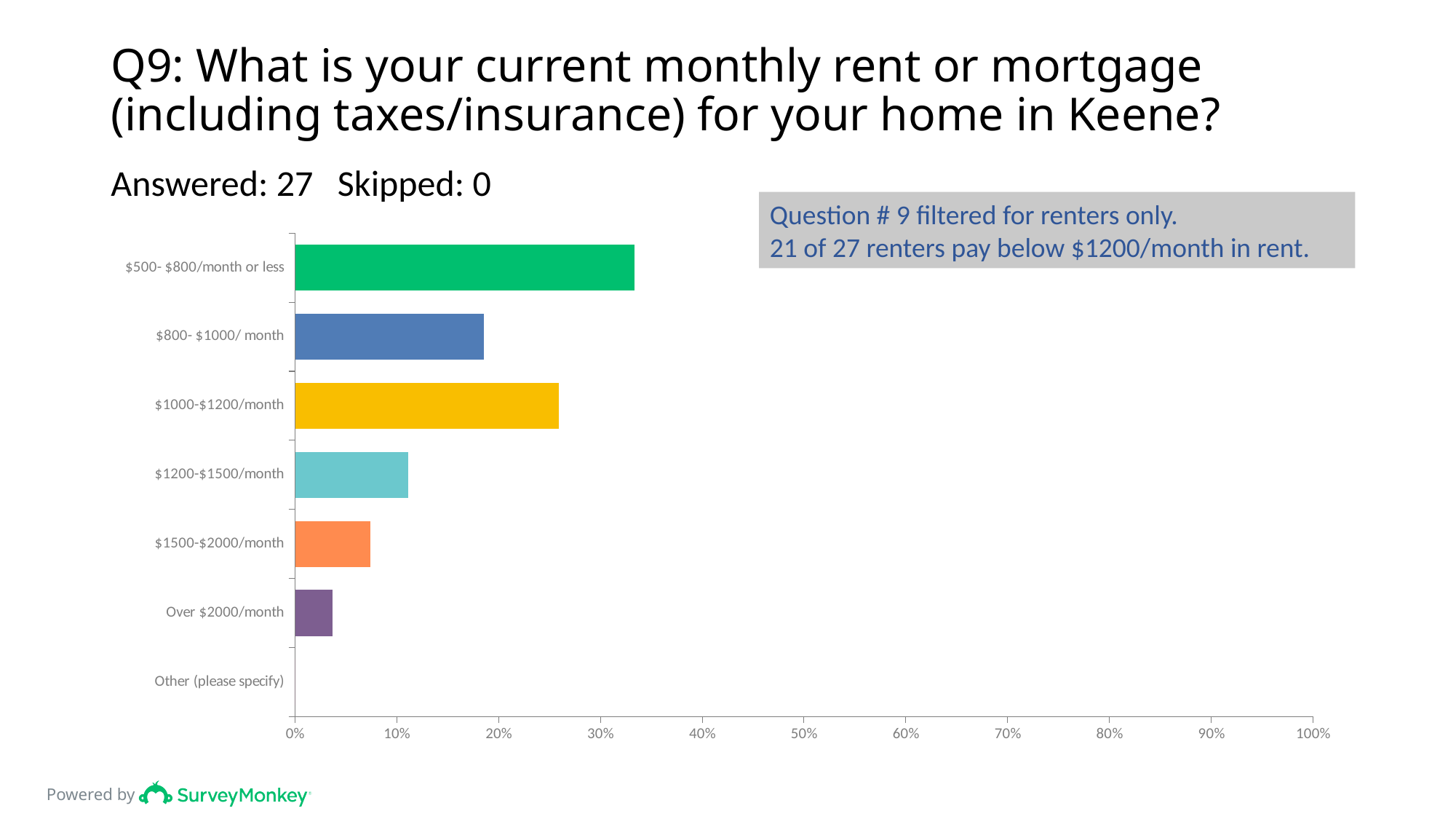
Is the value for $800- $1000/ month greater or less than 20%? less Is the value for $500- $800/month or less greater or less than 30%? greater Is the value for $1000-$1200/month greater or less than 20%? greater Which is larger, the value for $1000-$1200/month or the value for $800- $1000/ month? $1000-$1200/month Which category shows no bar at all? Other (please specify) Which category has the shortest visible bar? Over $2000/month What is the maximum value shown on the horizontal axis? 100% What kind of chart is shown on the slide? bar chart Which category has the longest bar? $500- $800/month or less How many categories are listed on the chart's vertical axis? 7 Which is larger, the value for $1200-$1500/month or the value for Over $2000/month? $1200-$1500/month